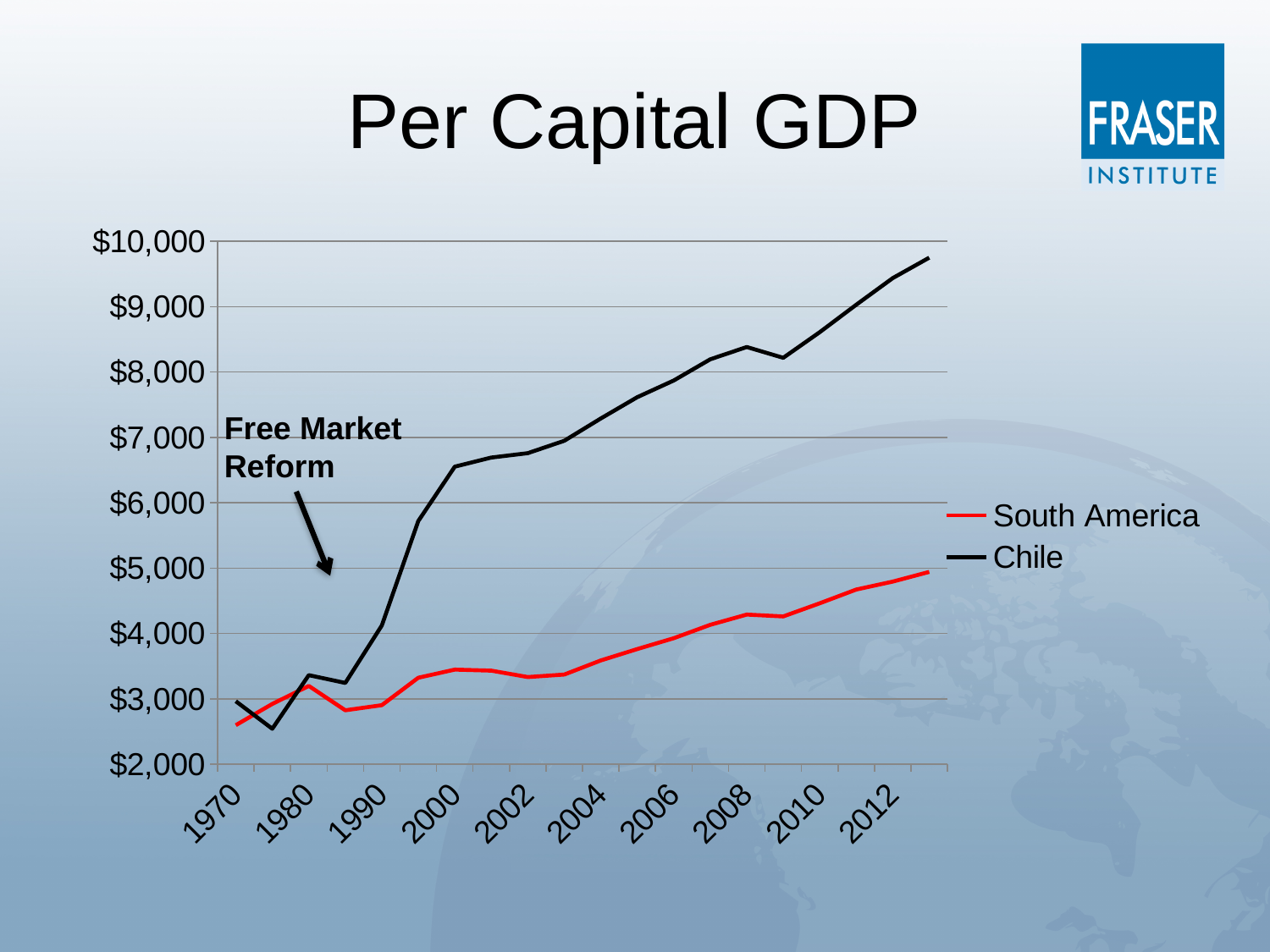
Is the value for South America in 2004 greater or less than $4,000? less What is the title of the chart? Per Capital GDP In 2012, which series has the higher value, Chile or South America? Chile What event does the annotation with the arrow on the chart label? Free Market Reform Is the value for South America in 2012 greater or less than $4,000? greater Is the value for Chile in 2000 greater or less than $6,000? greater What kind of chart is shown on the slide? line chart How many series does the legend list? 2 How many year labels are shown on the x axis? 10 Does the Chile line rise or fall from 1990 to 2012? rise